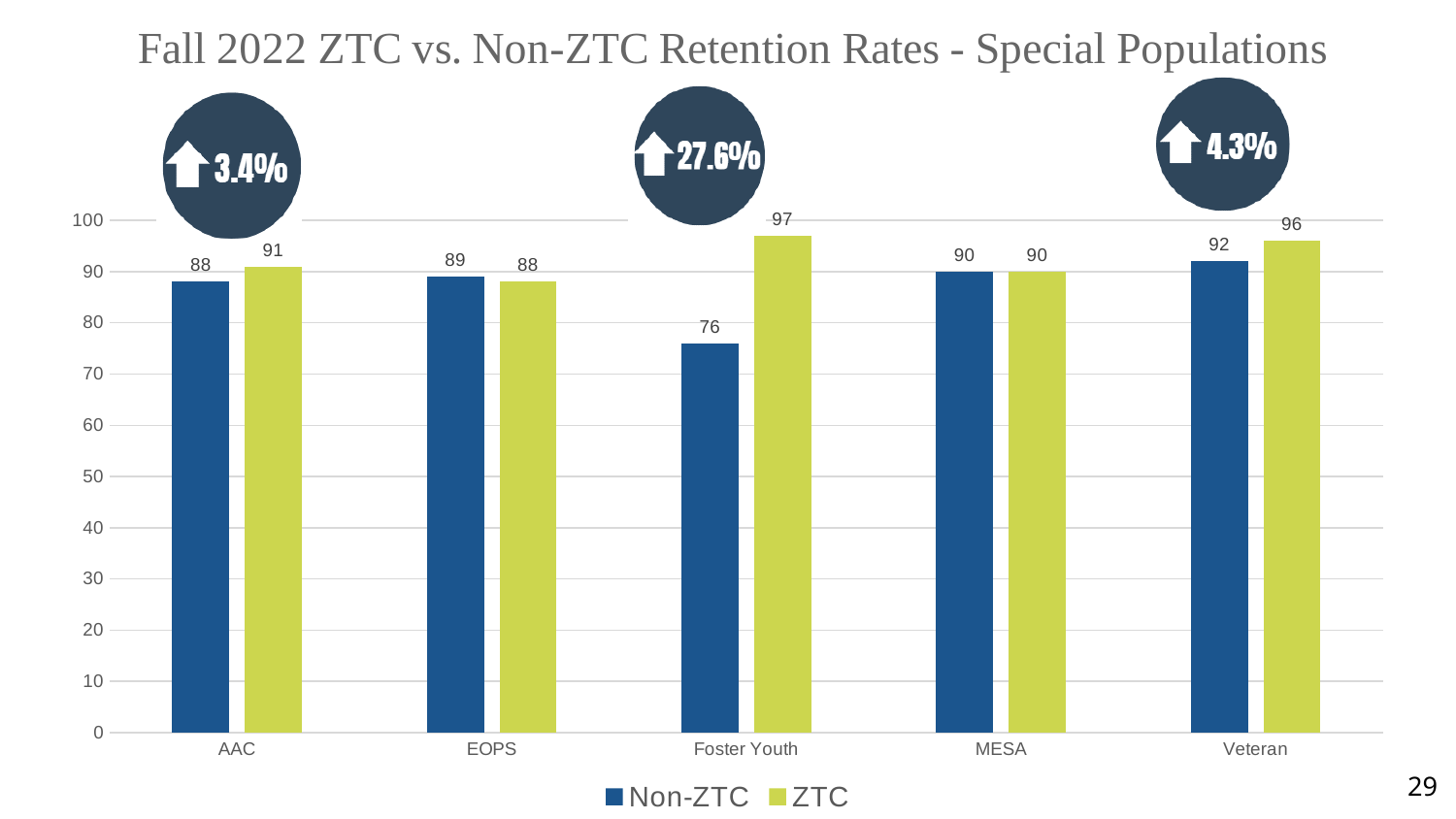
How many series does the legend list? 2 What is the ZTC retention rate for Foster Youth? 97 How many categories are shown on the x axis? 5 Which category has the lowest Non-ZTC value? Foster Youth Which category has the highest ZTC value? Foster Youth What is the title of the chart? Fall 2022 ZTC vs. Non-ZTC Retention Rates - Special Populations What is the Non-ZTC retention rate for Veteran? 92 What kind of chart is shown on the slide? Bar chart Which is larger for EOPS, the Non-ZTC value or the ZTC value? Non-ZTC What is the difference between the ZTC and Non-ZTC values for Foster Youth? 21 What is the Non-ZTC value for EOPS? 89 What colour are the ZTC bars? Yellow-green